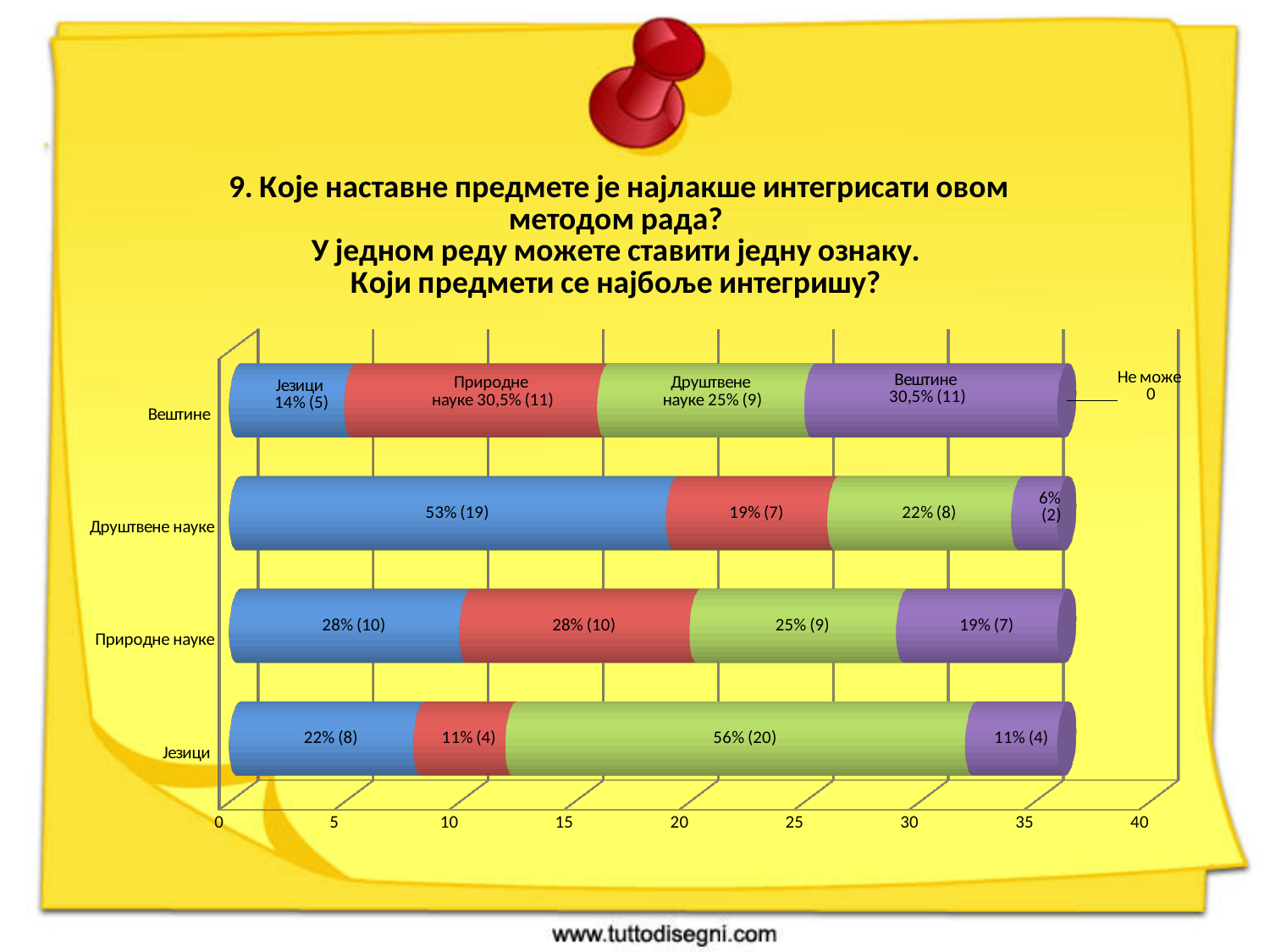
In the Језици bar, how much larger is the count of the green segment (20) than the count of the blue segment (8)? 12 What kind of chart is shown on the slide? Stacked bar chart How many categories (rows) are shown on the vertical axis of the chart? 4 Which segment of the Друштвене науке bar has the smallest value? The purple segment, 6% (2) What is the total count across all segments of the Природне науке bar (using the counts in parentheses)? 36 Which segment of the Језици bar has the largest value? The green segment, 56% (20) What is the data label for the Природне науке segment in the Вештине bar? 30,5% (11) What is the data label for the green segment of the Језици bar? 56% (20) What is the data label for the blue segment of the Друштвене науке bar? 53% (19) What is the data label for the Језици segment in the Вештине bar? 14% (5) What is the highest value shown on the horizontal axis of the chart? 40 What is the data label for the purple segment of the Друштвене науке bar? 6% (2)